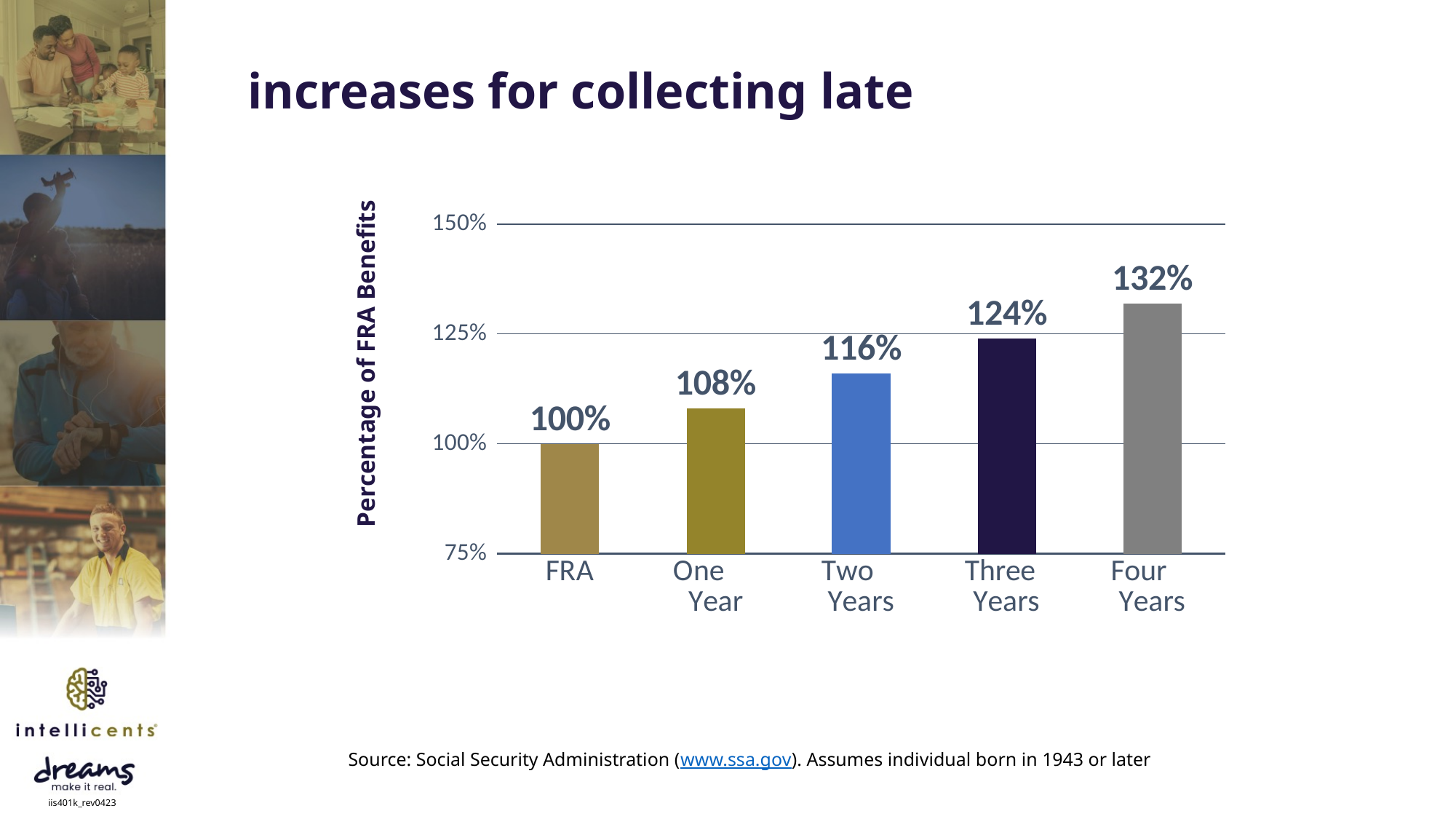
What is the difference between the values for Three Years and One Year? 16% Do the values rise or fall from FRA to Four Years? rise What kind of chart is shown on the slide? bar chart What is the value for Four Years? 132% What is the value for One Year? 108% Which is larger, the value for Two Years or the value for Three Years? Three Years What is the label of the vertical axis? Percentage of FRA Benefits How many categories are shown on the x axis? 5 What is the value for Two Years? 116% Which category has the highest value? Four Years Which category has the lowest value? FRA Is the value for Four Years greater or less than 125%? greater